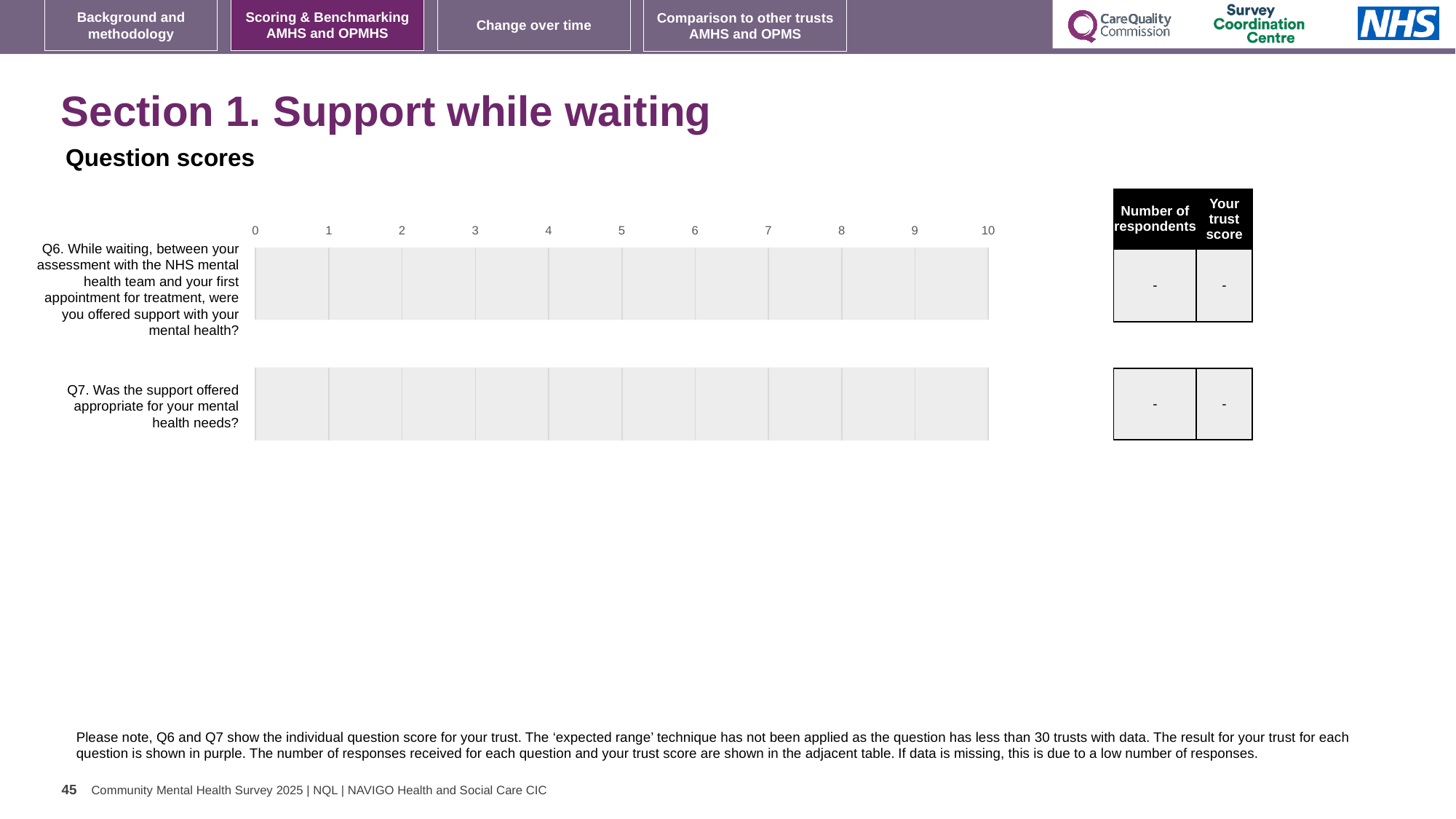
How many questions (categories) are listed on the chart? 2 Are any bars plotted for Q6 or Q7 on the chart? No What kind of chart is shown on the slide? bar chart What is the lowest value shown on the chart's x axis? 0 What is the 'Your trust score' value shown in the table for Q6? - What is the highest value shown on the chart's x axis? 10 What is the 'Number of respondents' value shown in the table for Q7? -